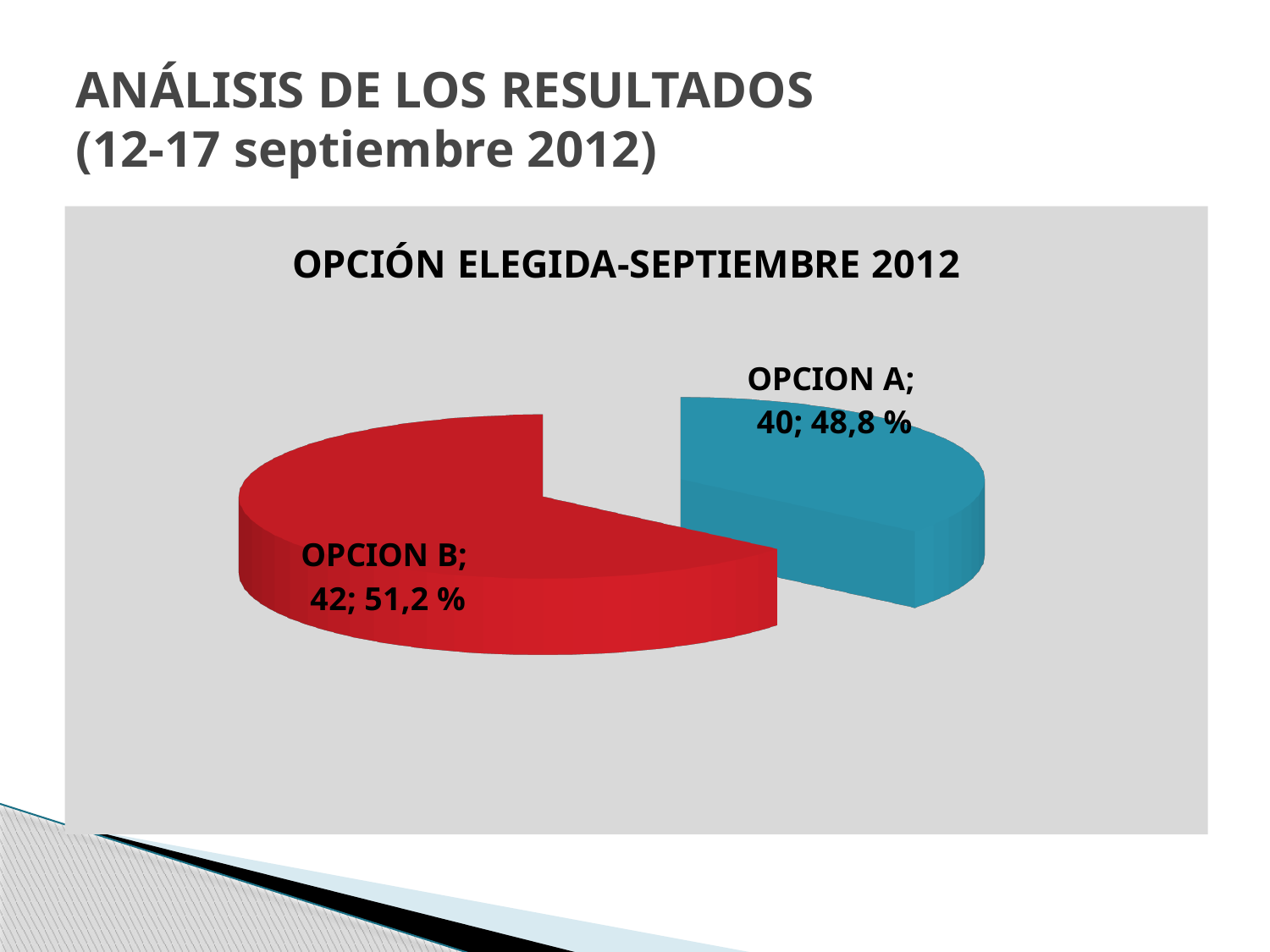
What kind of chart is shown on the slide? pie chart Which option has the largest slice? OPCION B How many slices does the pie chart have? 2 What is the total of the values for OPCION A and OPCION B? 82 What is the value for OPCION B? 42 What share of the pie does OPCION B represent? 51,2 % Which option has the smallest slice? OPCION A What share of the pie does OPCION A represent? 48,8 % What is the difference between the values for OPCION B and OPCION A? 2 What is the title of the chart? OPCIÓN ELEGIDA-SEPTIEMBRE 2012 What is the value for OPCION A? 40 What colour is the slice for OPCION B? red